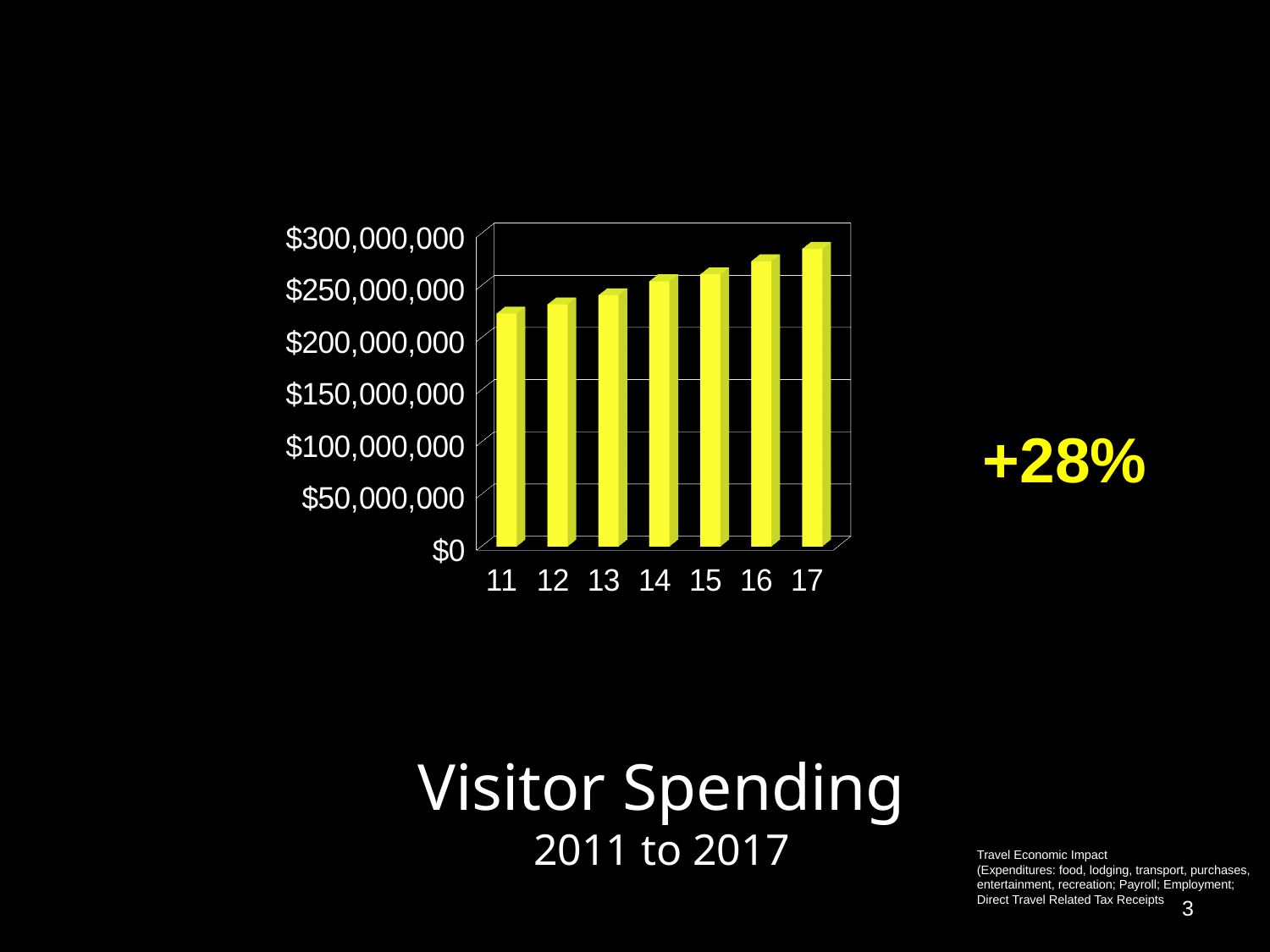
Which year has the lowest visitor spending? 11 Is the value for 17 greater or less than $300,000,000? less What is the title of the chart? Visitor Spending 2011 to 2017 Which year has the highest visitor spending? 17 What percentage change is shown next to the chart? +28% Is the value for 12 greater or less than $250,000,000? less Is the value for 11 greater or less than $200,000,000? greater What kind of chart is shown on the slide? bar chart Do the values rise or fall from 11 to 17 along the x axis? rise How many bars (years) are plotted in the chart? 7 Which is larger, the value for 17 or the value for 11? 17